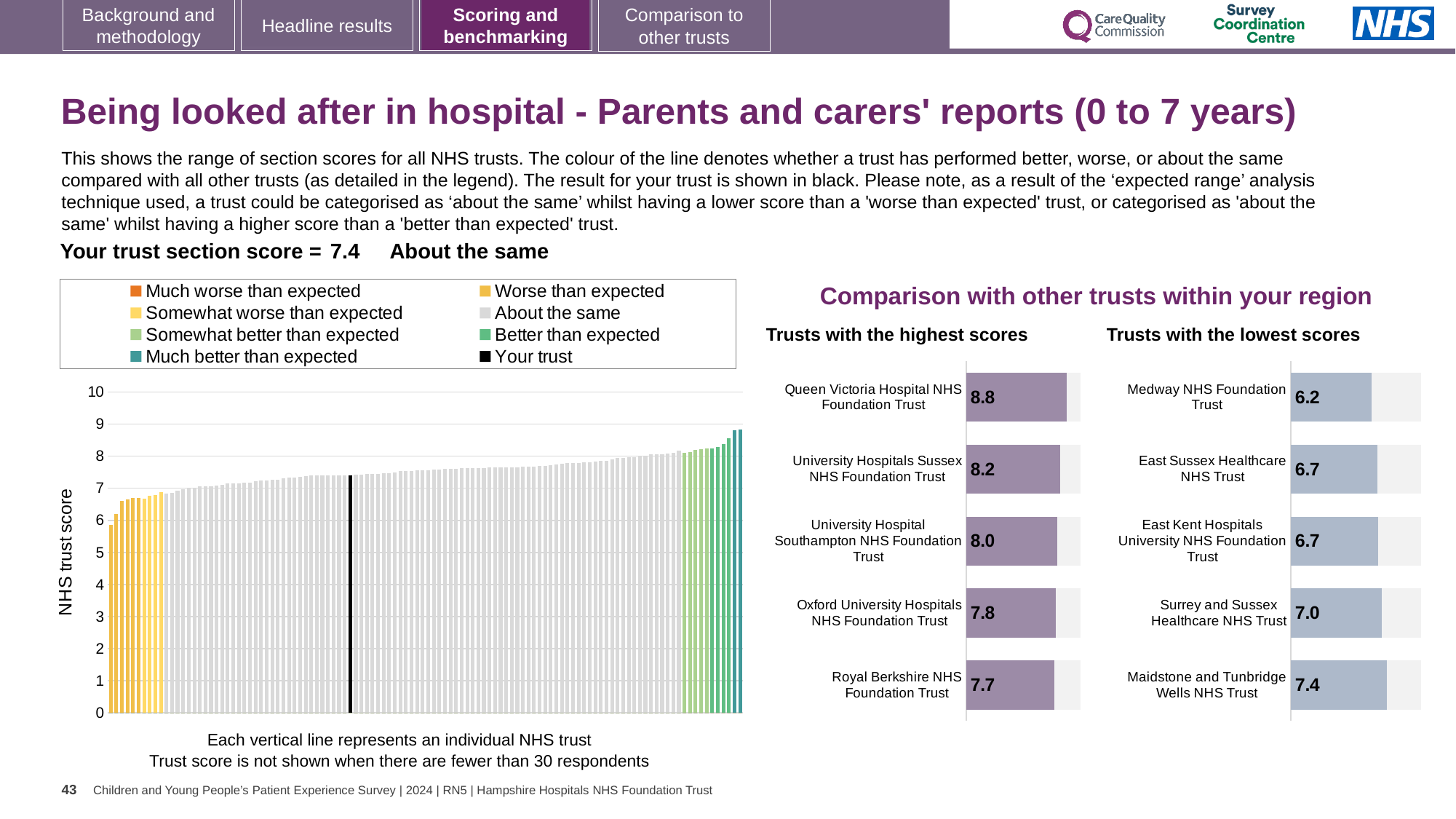
In the 'Trusts with the lowest scores' chart, what is the score for Medway NHS Foundation Trust? 6.2 In the 'Trusts with the lowest scores' chart, which trust has the highest score? Maidstone and Tunbridge Wells NHS Trust What kind of chart is the large chart on the left showing all NHS trust scores? Bar chart In the 'Trusts with the lowest scores' chart, what is the difference between the scores of East Sussex Healthcare NHS Trust and Medway NHS Foundation Trust? 0.5 In the 'Trusts with the highest scores' chart, what is the difference between the scores of Queen Victoria Hospital NHS Foundation Trust and Royal Berkshire NHS Foundation Trust? 1.1 How many entries does the legend above the large chart on the left list? 8 In the large chart on the left, do the trust scores rise or fall from left to right? Rise What is the label on the vertical axis of the large chart on the left? NHS trust score In the 'Trusts with the highest scores' chart, what is the score for Queen Victoria Hospital NHS Foundation Trust? 8.8 How many trusts are listed in the 'Trusts with the highest scores' chart? 5 Which has the higher score: Oxford University Hospitals NHS Foundation Trust in the highest-scores chart or Surrey and Sussex Healthcare NHS Trust in the lowest-scores chart? Oxford University Hospitals NHS Foundation Trust In the 'Trusts with the highest scores' chart, which trust has the lowest score? Royal Berkshire NHS Foundation Trust